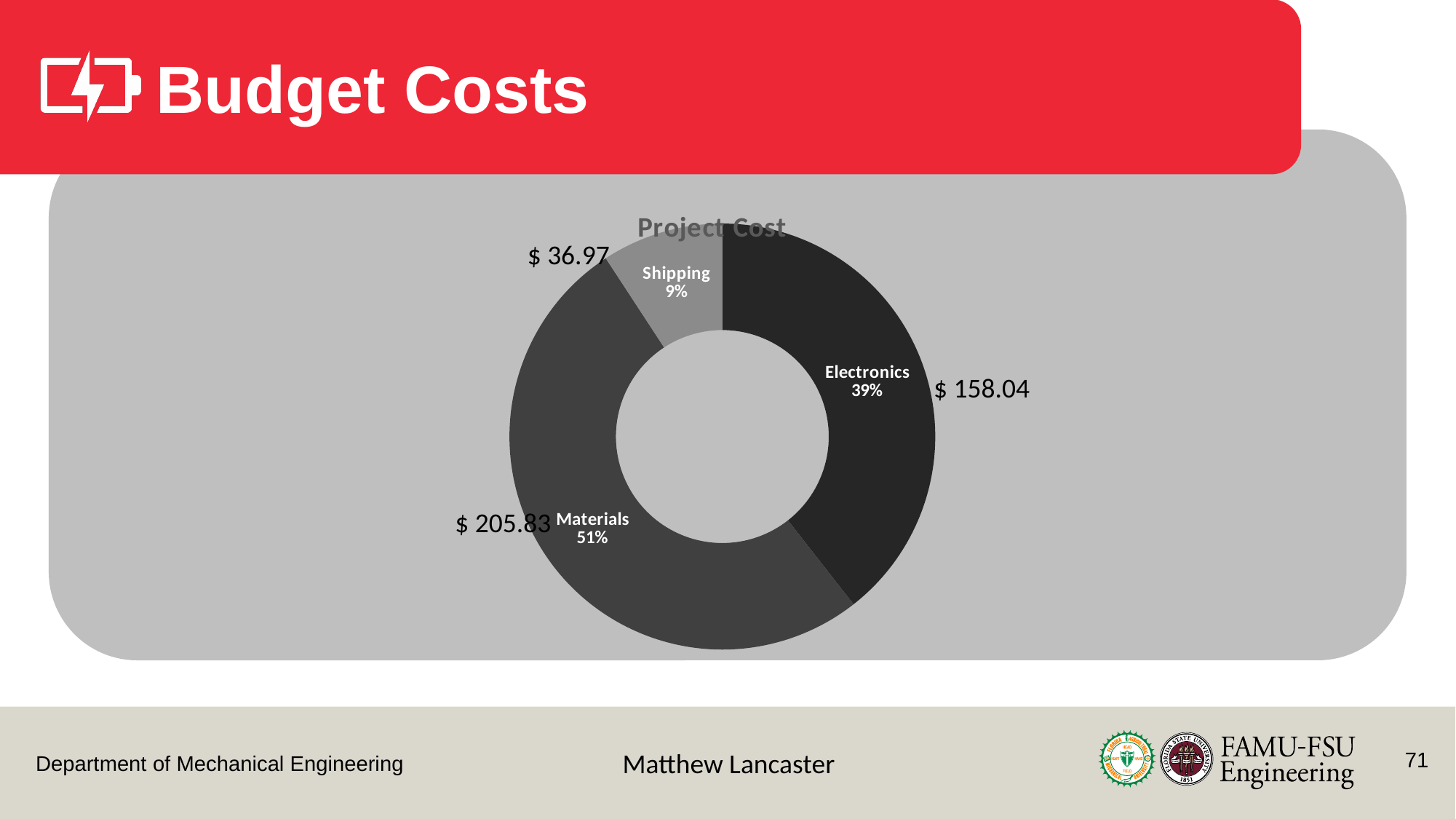
What is the difference between the Materials cost and the Electronics cost? $ 47.79 Which is larger, the cost for Electronics or the cost for Shipping? Electronics What is the value for Shipping in the Project Cost chart? $ 36.97 Which category has the highest cost in the Project Cost chart? Materials How many categories are shown in the Project Cost chart? 3 What is the value for Electronics in the Project Cost chart? $ 158.04 What share of the Project Cost does Materials represent? 51% What is the value for Materials in the Project Cost chart? $ 205.83 Which category has the lowest cost in the Project Cost chart? Shipping What kind of chart is shown on the slide? Doughnut (pie) chart What share of the Project Cost does Electronics represent? 39% What share of the Project Cost does Shipping represent? 9%